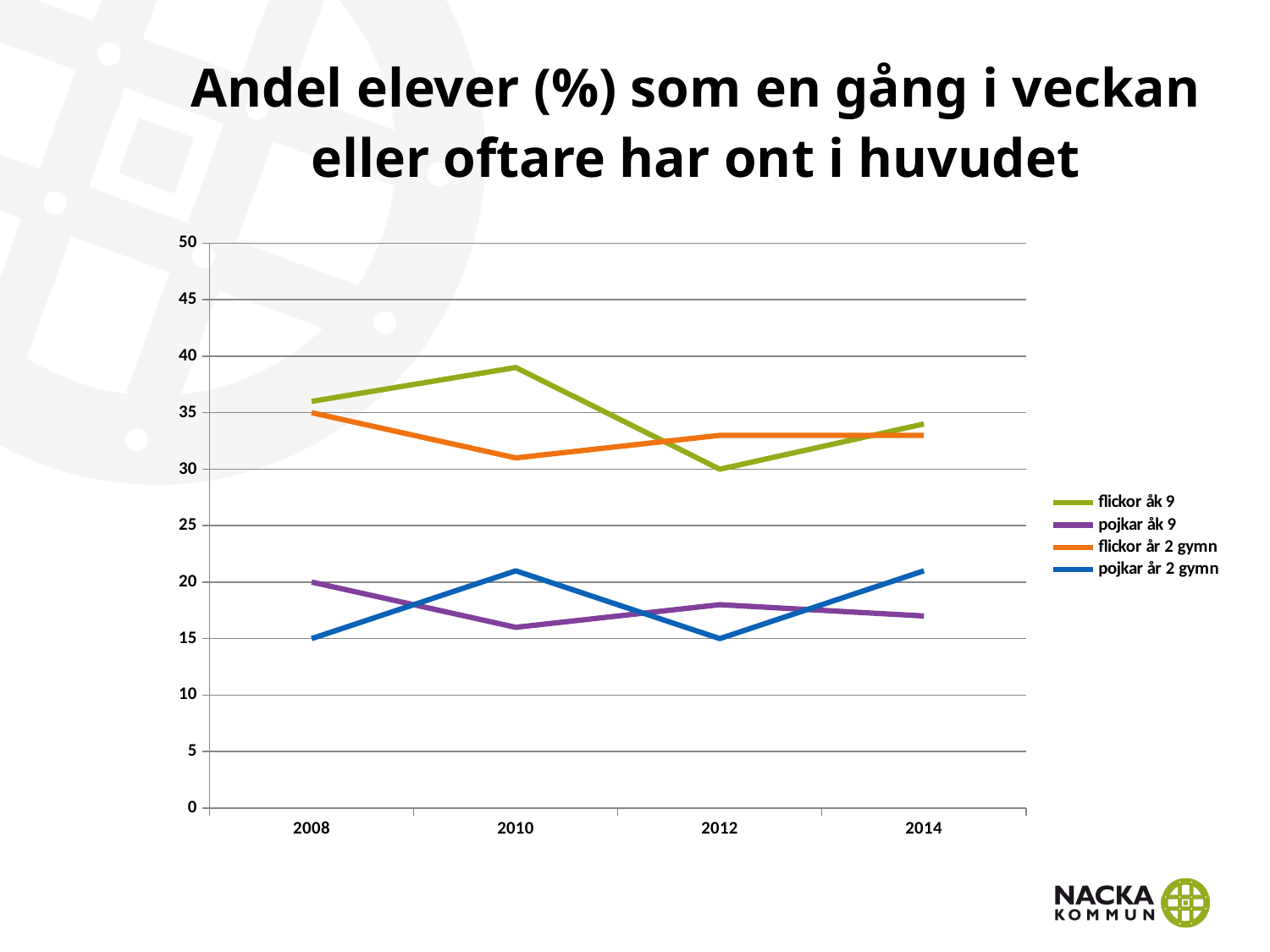
Is the value for flickor år 2 gymn in 2010 greater or less than 35? less What is the value for pojkar åk 9 in 2008? 20 Which series has the lowest value in 2008? pojkar år 2 gymn How many years are shown on the x axis? 4 What is the value for flickor åk 9 in 2012? 30 What kind of chart is shown on the slide? line chart Is the value for flickor åk 9 in 2010 greater or less than 35? greater Which is larger in 2010, flickor åk 9 or flickor år 2 gymn? flickor åk 9 What is the value for pojkar år 2 gymn in 2008? 15 In which year is the value for flickor åk 9 highest? 2010 How many series does the legend list? 4